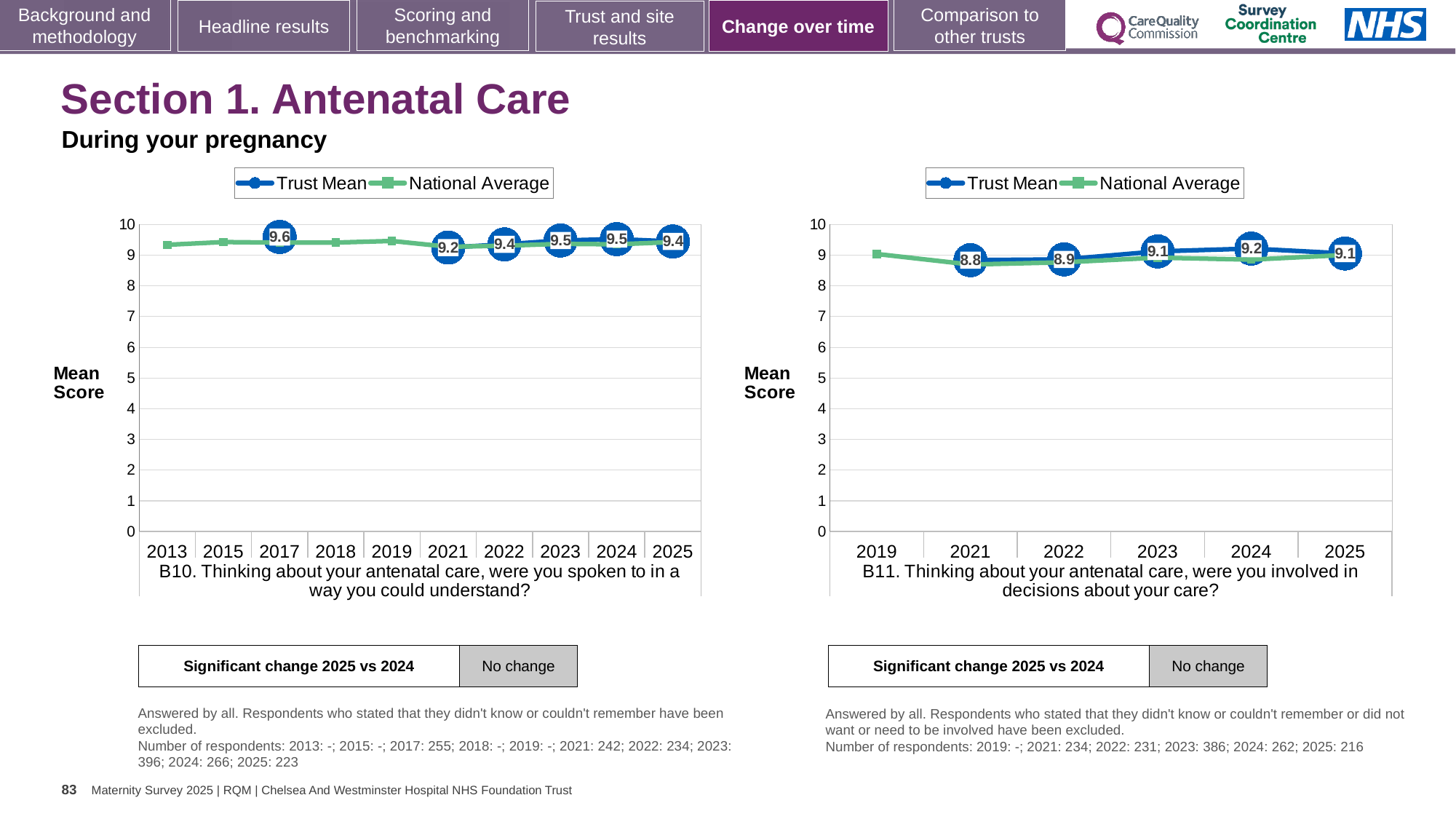
In the B11 chart, is the National Average value for 2019 greater or less than 8? greater What does the 'Significant change 2025 vs 2024' box under the B10 chart say? No change In the B10 chart, what is the Trust Mean score for 2017? 9.6 In the B11 chart, does the Trust Mean score rise or fall from 2021 to 2024? Rise In the B11 chart, what is the Trust Mean score for 2025? 9.1 What kind of chart is the B10 chart? Line chart In the B10 chart, which year has the highest Trust Mean score? 2017 In the B11 chart, is the Trust Mean score higher in 2024 or in 2021? 2024 In the B11 chart, which year has the lowest Trust Mean score? 2021 How many years are shown on the x axis of the B10 chart? 10 How many series does the legend of the B11 chart list? 2 In the B10 chart, what is the difference between the Trust Mean scores for 2017 and 2021? 0.4